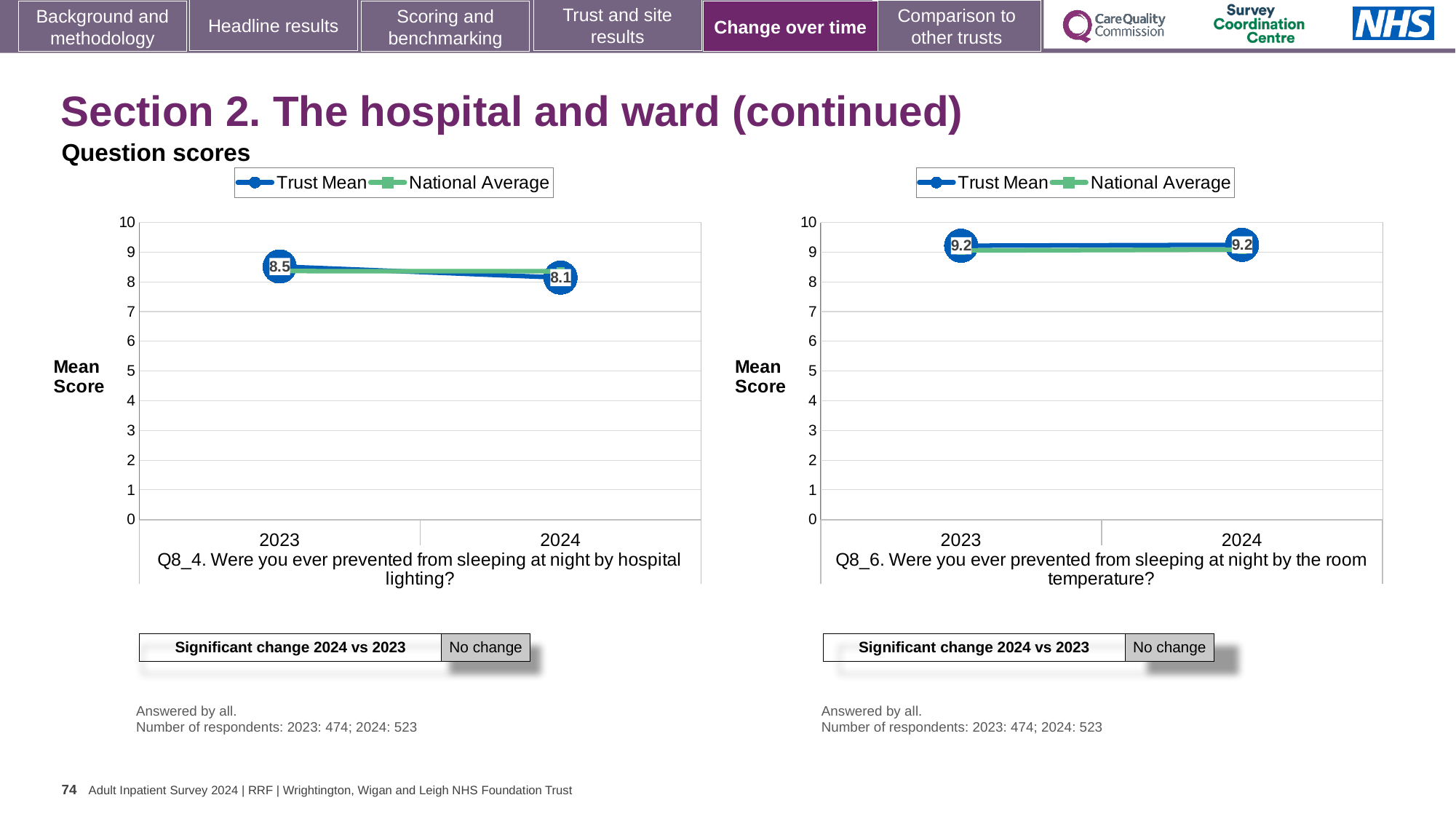
In the Q8_4 hospital lighting chart, what is the Trust Mean for 2024? 8.1 How many series does the legend of the Q8_4 hospital lighting chart list? 2 In the Q8_4 hospital lighting chart, is the National Average for 2023 greater or less than 7? greater In the Q8_4 hospital lighting chart, what is the Trust Mean for 2023? 8.5 How many years are shown on the x axis of the Q8_6 room temperature chart? 2 What does the 'Significant change 2024 vs 2023' box say for the Q8_6 room temperature chart? No change In the Q8_6 room temperature chart, does the Trust Mean rise, fall or stay the same from 2023 to 2024? stay the same In the Q8_4 hospital lighting chart, which year has the higher Trust Mean, 2023 or 2024? 2023 In the Q8_6 room temperature chart, what is the Trust Mean for 2024? 9.2 In the Q8_4 hospital lighting chart, does the Trust Mean rise or fall from 2023 to 2024? fall What kind of chart is the Q8_6 room temperature chart? line chart In the Q8_4 hospital lighting chart, what is the difference between the Trust Mean for 2023 and 2024? 0.4